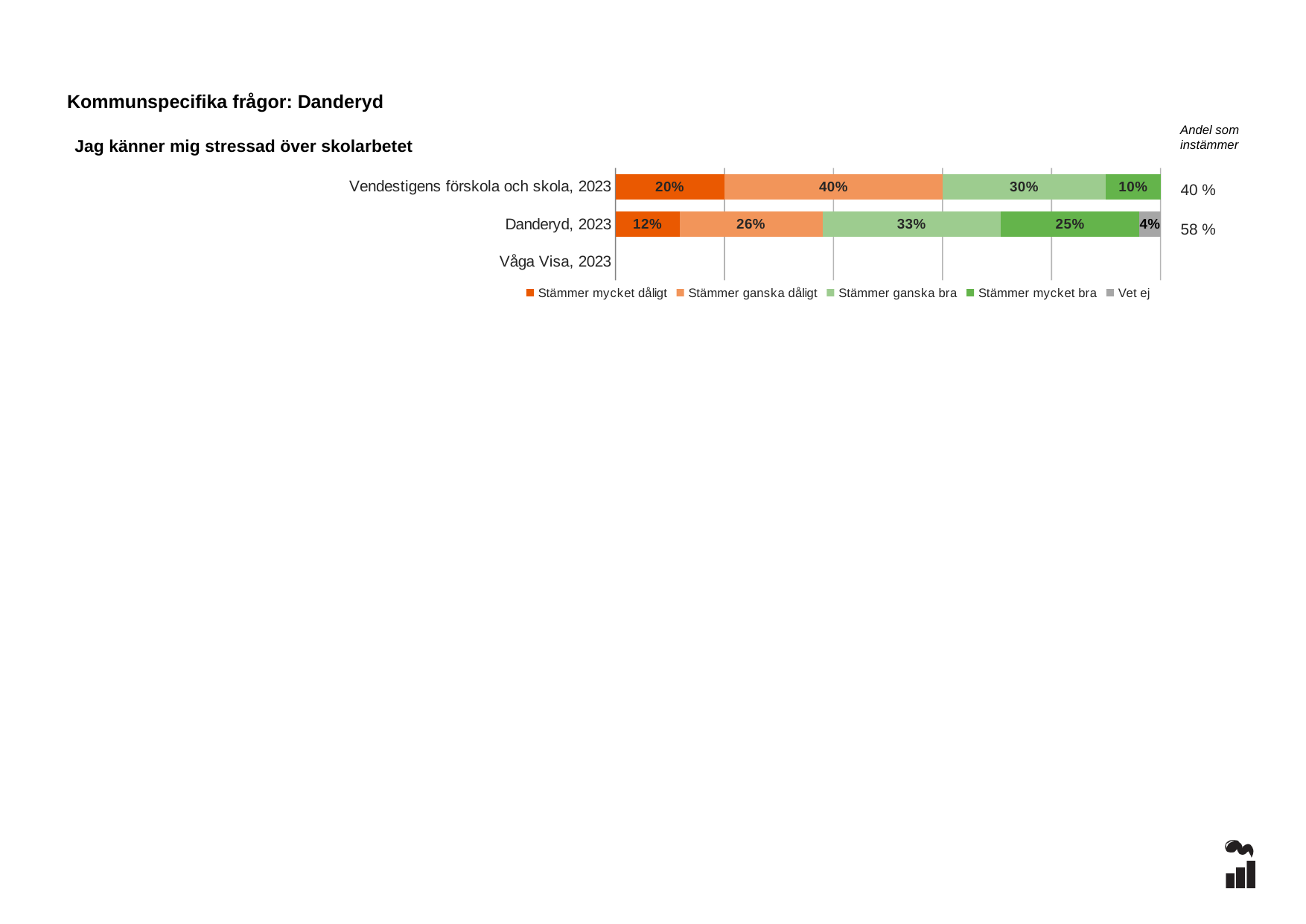
What is the value for "Vet ej" for Danderyd, 2023? 4% What is the value for "Stämmer mycket dåligt" for Vendestigens förskola och skola, 2023? 20% What kind of chart is shown on the slide? Stacked bar chart How many series does the legend list? 5 What is the "Andel som instämmer" value shown for Danderyd, 2023? 58 % What is the value for "Stämmer ganska dåligt" for Vendestigens förskola och skola, 2023? 40% Which response category has the lowest value for Danderyd, 2023? Vet ej What is the difference between the "Stämmer ganska bra" values for Danderyd, 2023 and Vendestigens förskola och skola, 2023? 3 percentage points How many categories are listed on the vertical axis of the chart? 3 Which response category has the highest value for Vendestigens förskola och skola, 2023? Stämmer ganska dåligt What is the value for "Stämmer mycket bra" for Danderyd, 2023? 25% Which is larger: the "Stämmer mycket dåligt" value for Vendestigens förskola och skola, 2023 or for Danderyd, 2023? Vendestigens förskola och skola, 2023